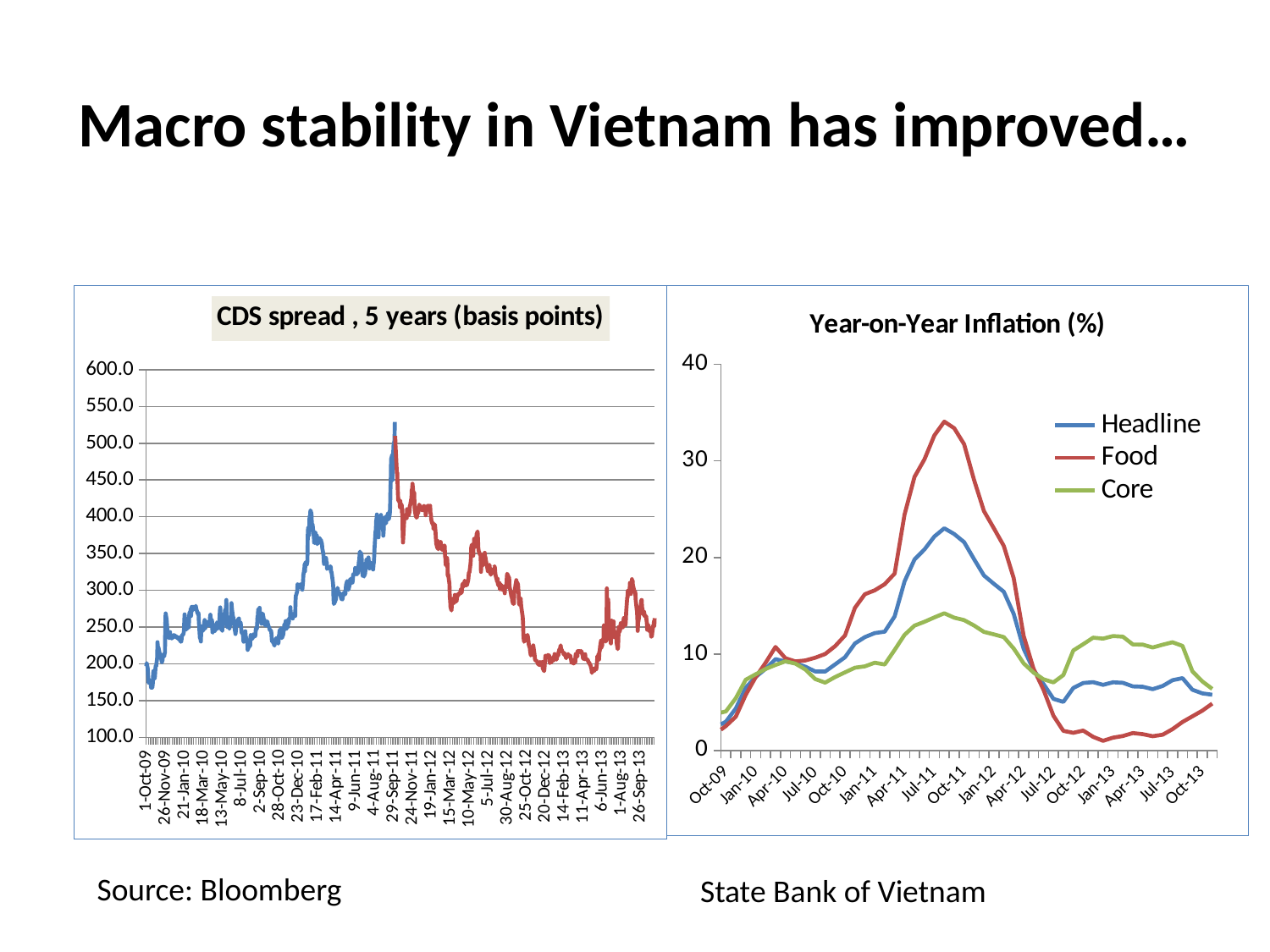
How many series does the legend of the 'Year-on-Year Inflation (%)' chart list? 3 In the 'Year-on-Year Inflation (%)' chart, which series has the highest value around Oct-11? Food Which series are listed in the legend of the 'Year-on-Year Inflation (%)' chart? Headline, Food, Core In the 'Year-on-Year Inflation (%)' chart, which series is higher around Jan-13, Core or Headline? Core What kind of chart is the 'Year-on-Year Inflation (%)' chart on the right? line chart What kind of chart is the 'CDS spread , 5 years (basis points)' chart on the left? line chart In the 'CDS spread , 5 years (basis points)' chart, does the spread rise or fall overall from its peak around 29-Sep-11 to the end of the series in 2013? fall In the 'CDS spread , 5 years (basis points)' chart, is the peak value reached around 29-Sep-11 greater or less than 500? greater Which source is cited for the 'CDS spread , 5 years (basis points)' chart? Bloomberg In the 'Year-on-Year Inflation (%)' chart, which series has the lowest value around Jan-13? Food In the 'Year-on-Year Inflation (%)' chart, is the peak of the Food series greater or less than 30? greater In the 'Year-on-Year Inflation (%)' chart, is the peak of the Headline series greater or less than 20? greater